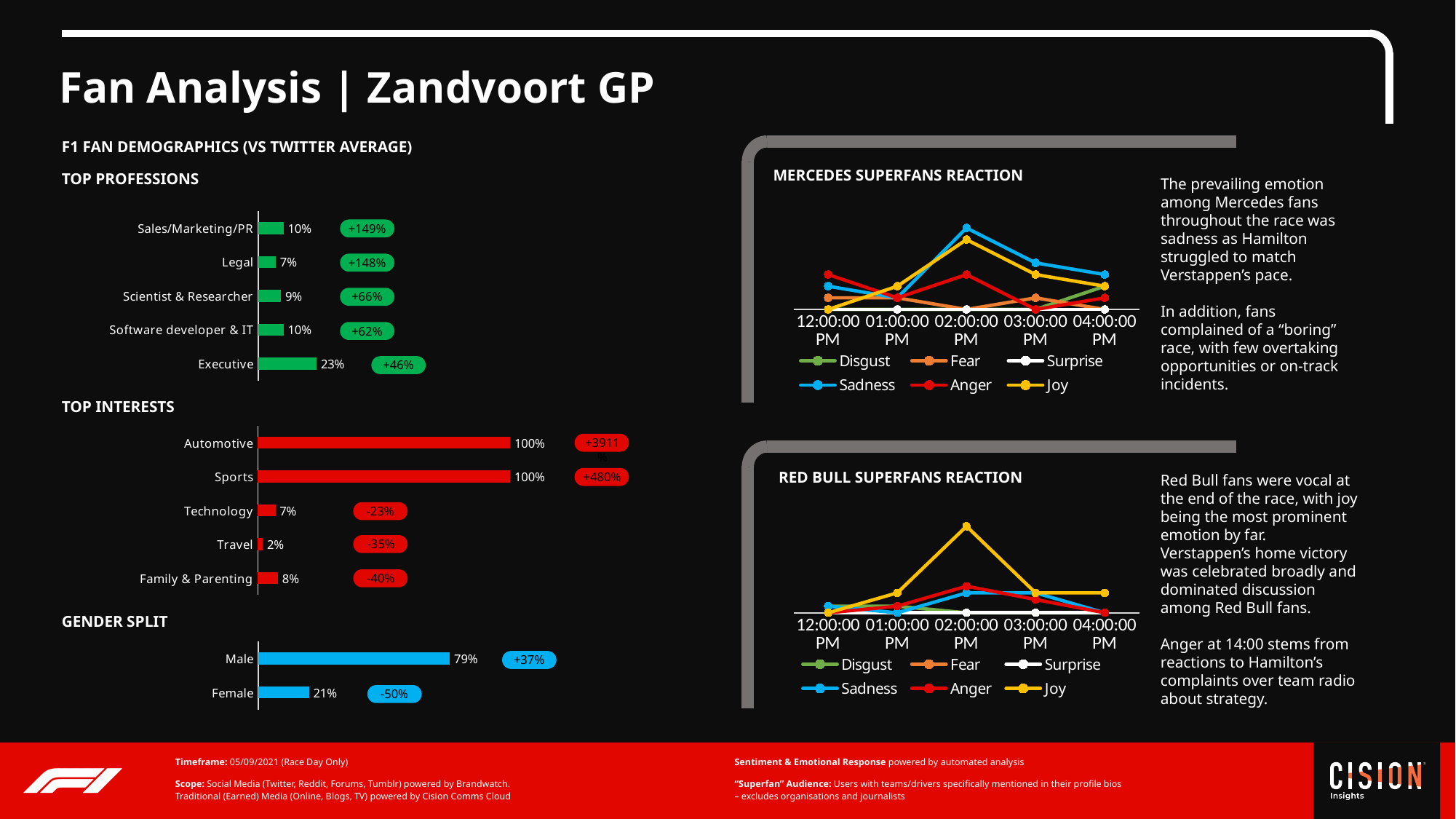
In the Gender Split chart, what is the value for Female? 21% In the Top Professions chart, how many professions are listed? 5 In the Top Professions chart, which profession has the lowest value? Legal In the Top Professions chart, what is the value for Executive? 23% In the Top Interests chart, which interest has the lowest value? Travel What kind of chart is the Red Bull Superfans Reaction chart? Line chart In the Gender Split chart, what is the difference between the Male and Female values? 58% In the Red Bull Superfans Reaction chart, at which time does the Joy series reach its peak? 02:00:00 PM In the Top Professions chart, which profession has the highest value? Executive In the Top Interests chart, what is the value for Technology? 7% How many series does the legend of the Mercedes Superfans Reaction chart list? 6 In the Top Interests chart, what is the difference between the values for Family & Parenting and Travel? 6%